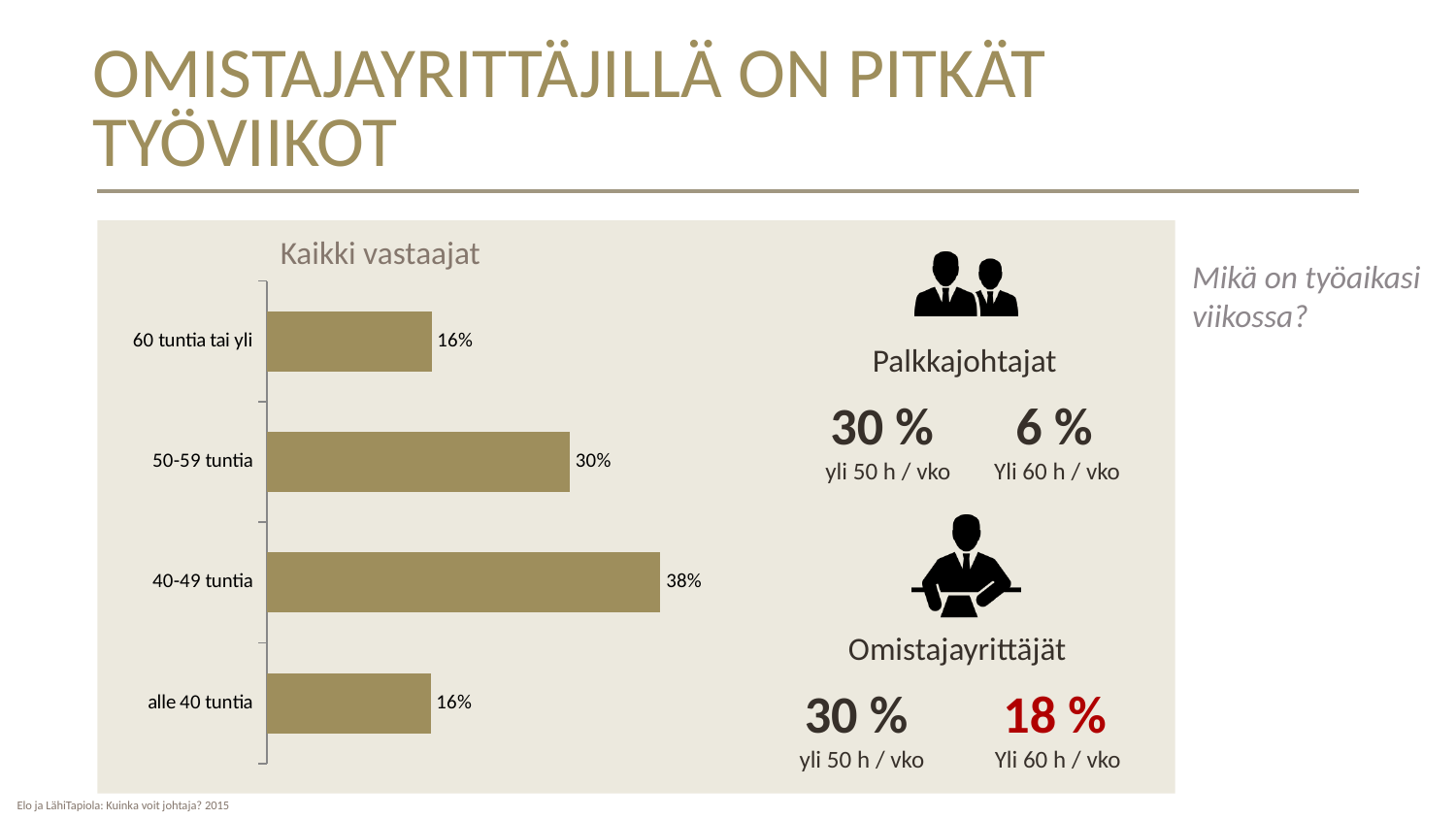
What is the value for "40-49 tuntia" in the Kaikki vastaajat chart? 38% How many categories are shown in the Kaikki vastaajat chart? 4 What kind of chart is the Kaikki vastaajat chart? Bar chart What is the difference between the values for "40-49 tuntia" and "50-59 tuntia" in the Kaikki vastaajat chart? 8% What is the difference between the values for "50-59 tuntia" and "60 tuntia tai yli" in the Kaikki vastaajat chart? 14% What is the title of the bar chart on the slide? Kaikki vastaajat What is the value for "alle 40 tuntia" in the Kaikki vastaajat chart? 16% Which category has the highest value in the Kaikki vastaajat chart? 40-49 tuntia Do the values for "60 tuntia tai yli" and "alle 40 tuntia" in the Kaikki vastaajat chart have the same value? Yes What is the value for "60 tuntia tai yli" in the Kaikki vastaajat chart? 16% What is the value for "50-59 tuntia" in the Kaikki vastaajat chart? 30% Which is larger in the Kaikki vastaajat chart: the value for "50-59 tuntia" or the value for "alle 40 tuntia"? 50-59 tuntia